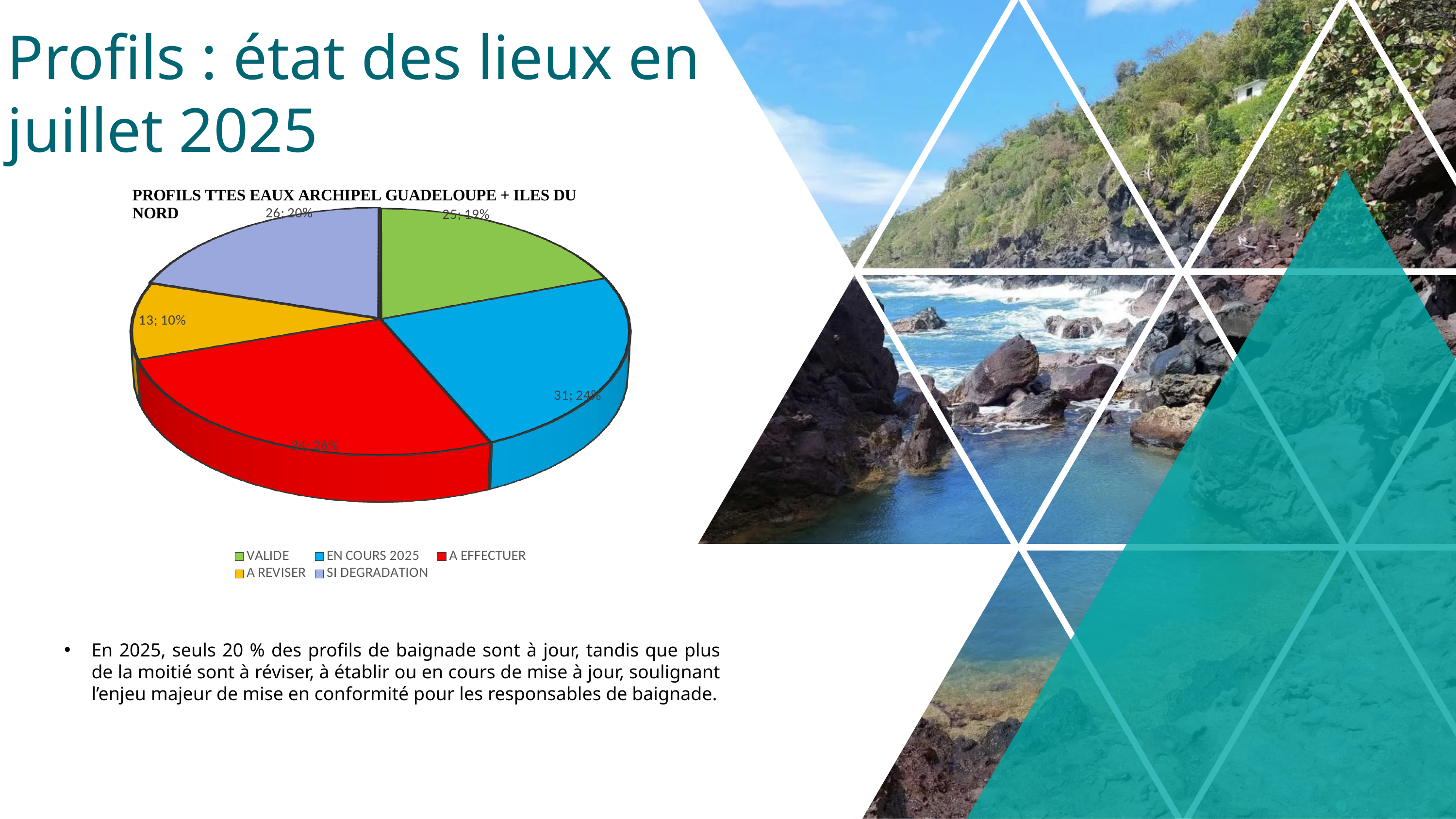
What share of the pie does SI DEGRADATION represent? 20% What is the difference between the values for A EFFECTUER and A REVISER? 21 What is the value for A EFFECTUER in the pie chart? 34 What is the value for A REVISER in the pie chart? 13 What share of the pie does VALIDE represent? 19% What kind of chart is shown on the slide? pie chart Which category has the largest slice of the pie chart? A EFFECTUER Which colour represents A EFFECTUER in the pie chart legend? red What is the value for EN COURS 2025 in the pie chart? 31 Which category has the smallest slice of the pie chart? A REVISER Which is larger, the value for EN COURS 2025 or the value for SI DEGRADATION? EN COURS 2025 How many categories does the pie chart have? 5